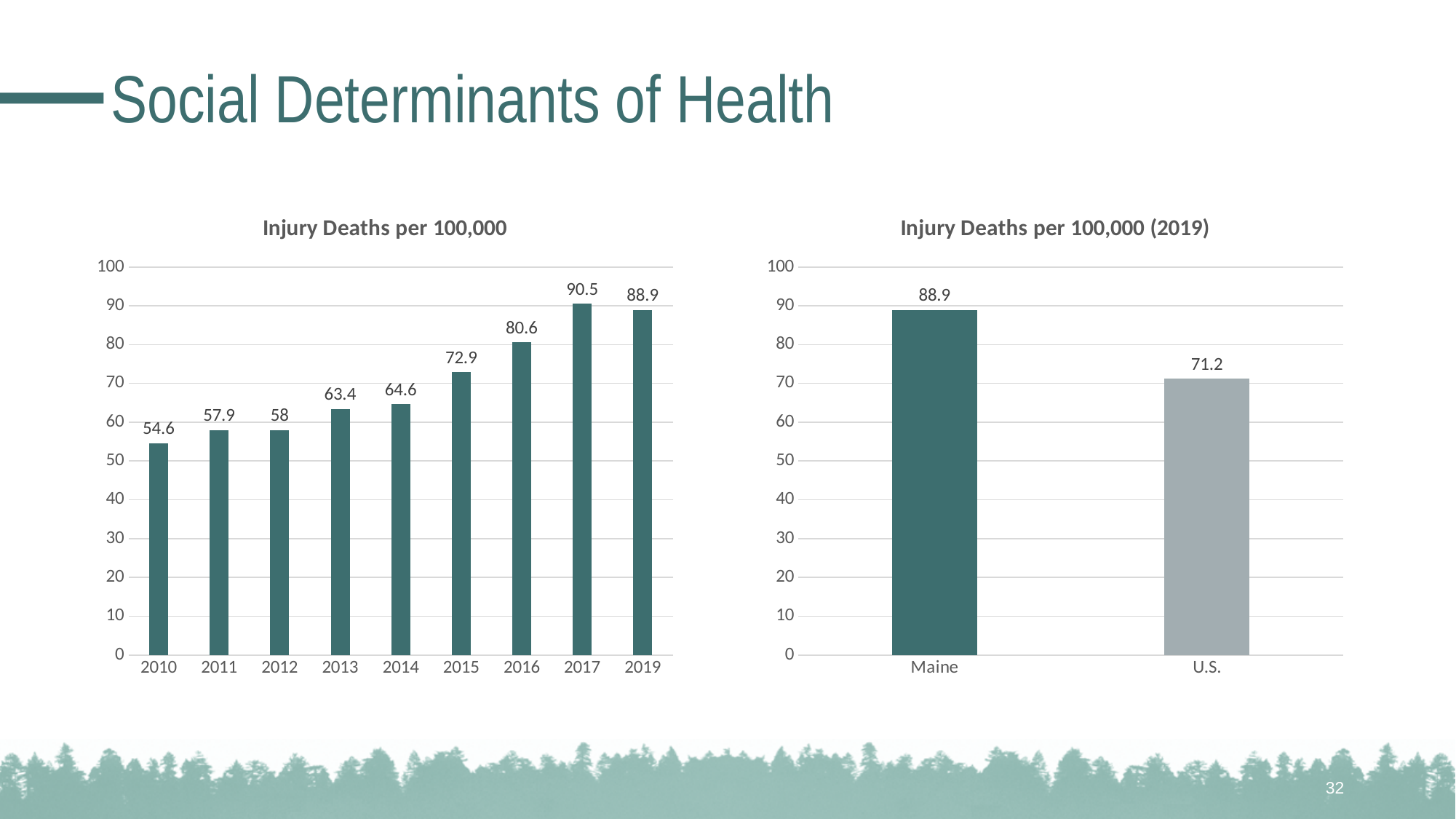
In the 'Injury Deaths per 100,000 (2019)' chart on the right, what is the difference between Maine and the U.S.? 17.7 In the 'Injury Deaths per 100,000' chart on the left, what is the value for 2010? 54.6 In the 'Injury Deaths per 100,000' chart on the left, how many years are shown on the x axis? 9 In the 'Injury Deaths per 100,000' chart on the left, what is the difference between the values for 2017 and 2019? 1.6 In the 'Injury Deaths per 100,000' chart on the left, which year has the highest value? 2017 What kind of chart is the 'Injury Deaths per 100,000 (2019)' chart on the right? bar chart In the 'Injury Deaths per 100,000 (2019)' chart on the right, which is larger, Maine or U.S.? Maine In the 'Injury Deaths per 100,000' chart on the left, is the value for 2016 greater or less than 80? greater In the 'Injury Deaths per 100,000 (2019)' chart on the right, what is the value for the U.S.? 71.2 In the 'Injury Deaths per 100,000' chart on the left, which year has the lowest value? 2010 In the 'Injury Deaths per 100,000' chart on the left, do the values generally rise or fall from 2010 to 2017? rise In the 'Injury Deaths per 100,000' chart on the left, what is the value for 2015? 72.9